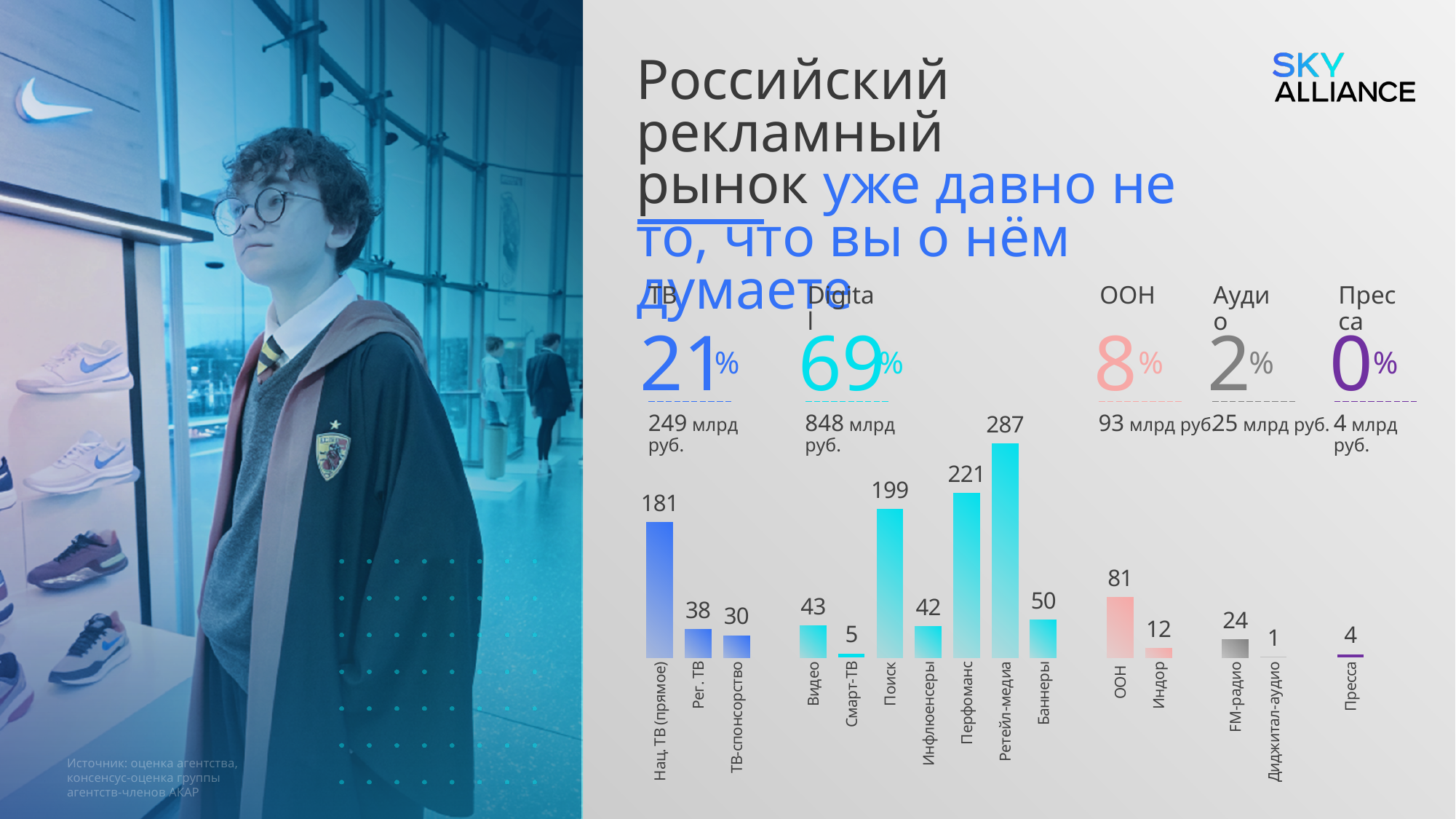
How many categories are shown on the x axis of the chart? 15 What is the difference between the values for Перфоманс and Поиск? 22 What is the value for Смарт-ТВ? 5 What kind of chart is shown on the slide? Bar chart What is the total of the values for ООН and Индор? 93 What is the value for Нац. ТВ (прямое)? 181 Which is larger, the value for Видео or the value for Инфлюенсеры? Видео Which category has the highest value? Ретейл-медиа What percentage share is shown for Digital? 69% What is the value for Ретейл-медиа? 287 Which category has the lowest value? Диджитал-аудио What amount in billions of rubles is shown for ТВ? 249 млрд руб.